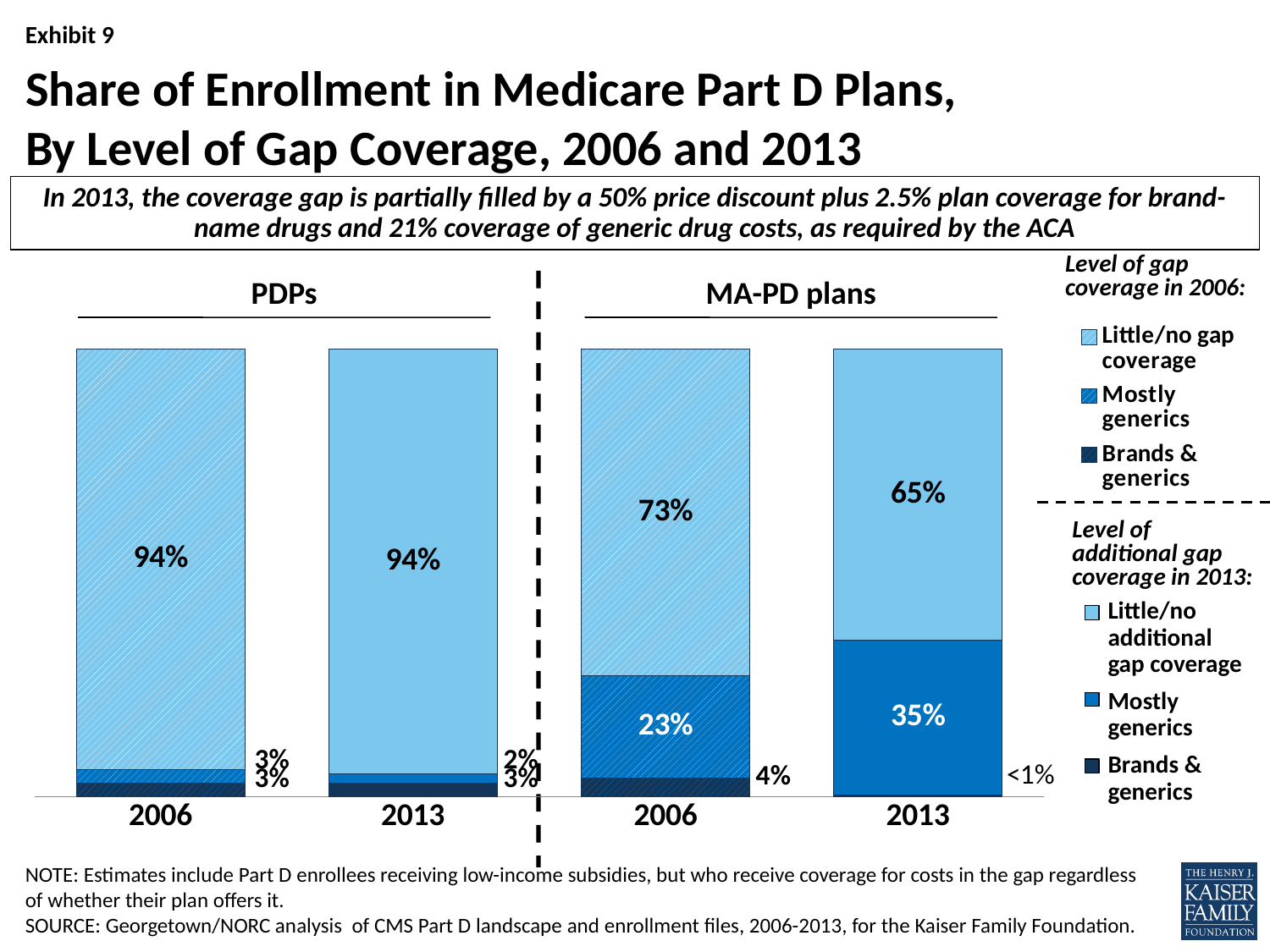
What share of MA-PD plan enrollment in 2006 was in plans with mostly generics gap coverage? 23% How many entries does the legend for level of gap coverage in 2006 list? 3 What share of MA-PD plan enrollment in 2013 was in plans with little/no additional gap coverage? 65% What share of MA-PD plan enrollment in 2013 was in plans covering mostly generics? 35% What share of MA-PD plan enrollment in 2006 was in plans covering brands & generics? 4% What share of PDP enrollment in 2006 was in plans with little/no gap coverage? 94% Which is larger: the mostly generics share for MA-PD plans in 2006 or in 2013? 2013 How many bars are plotted on the chart? 4 What is the difference between the little/no gap coverage share for MA-PD plans in 2006 and in 2013? 8% What type of chart is shown on the slide? Stacked bar chart What share of MA-PD plan enrollment in 2013 was in plans covering brands & generics? <1% Which bar has the largest mostly generics segment? MA-PD plans 2013